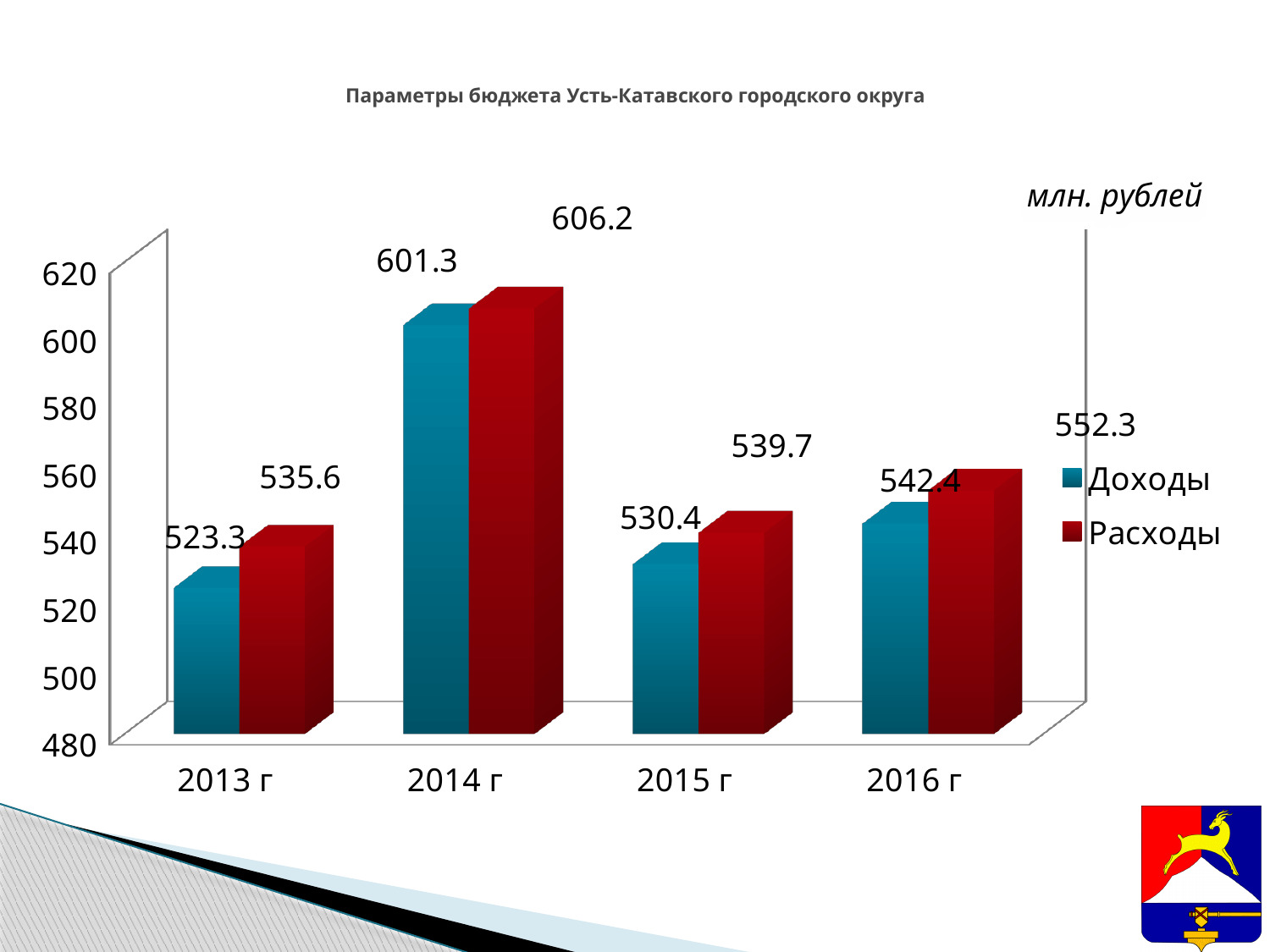
What is the difference between Расходы and Доходы in 2016 г? 9.9 What is the value of Расходы for 2013 г? 535.6 What unit is indicated for the values on the chart? млн. рублей Which is larger in 2015 г, Доходы or Расходы? Расходы In which year is Расходы the highest? 2014 г What is the value of Доходы for 2014 г? 601.3 In which year is Доходы the lowest? 2013 г How many series does the legend list? 2 What is the value of Доходы for 2016 г? 542.4 How many years are shown on the x axis? 4 What is the value of Расходы for 2015 г? 539.7 What kind of chart is shown on the slide? Bar chart